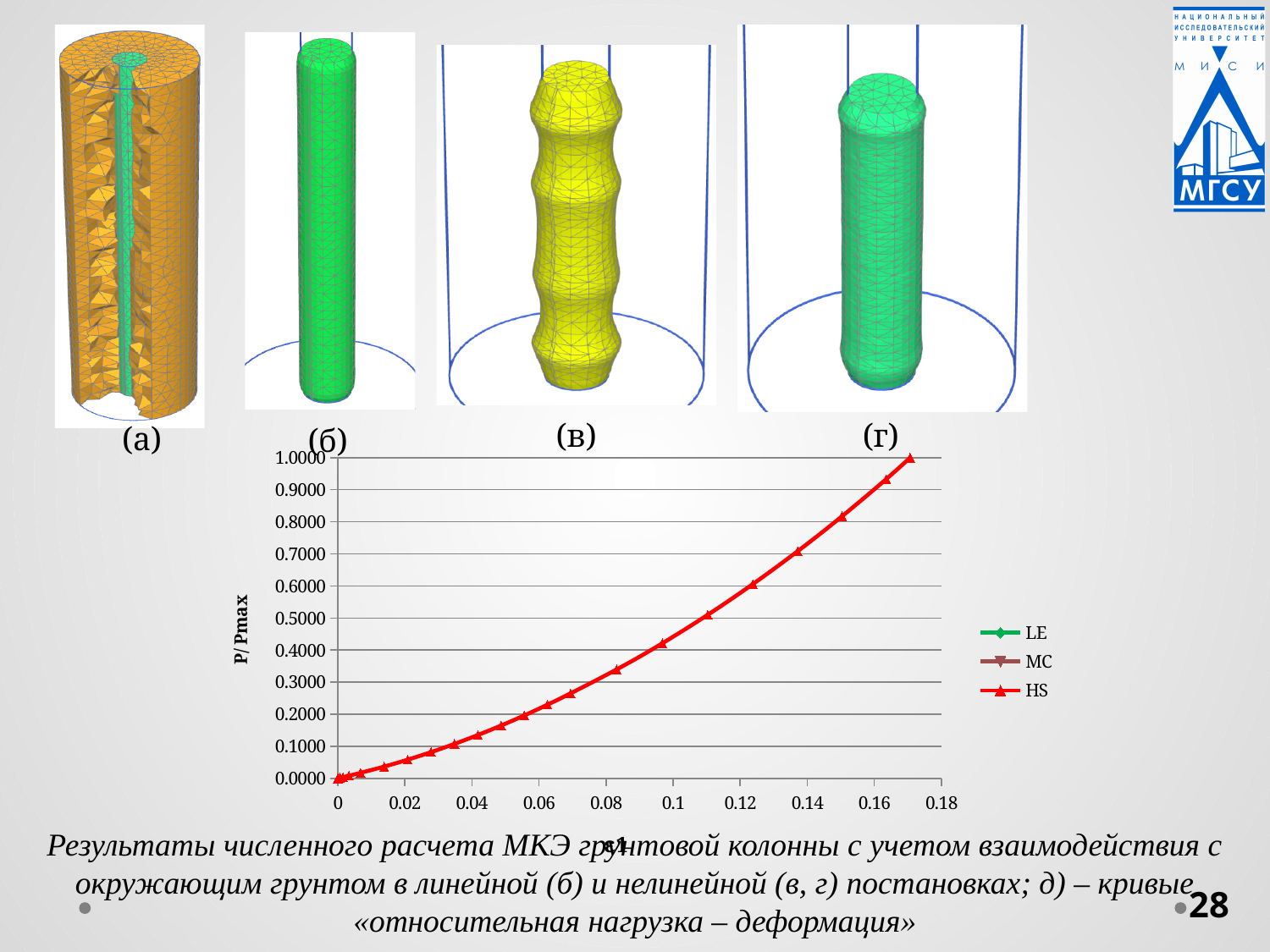
What is the label of the vertical axis of the chart? P/Pmax Is the P/Pmax value of the HS curve at x = 0.1 greater or less than 0.5000? less Is the P/Pmax value of the HS curve at x = 0.14 greater or less than 0.6000? greater What is the P/Pmax value of the HS curve at x = 0? 0.0000 What kind of chart is shown on the slide? line chart What is the highest P/Pmax value reached by the HS curve? 1.0000 What is the largest value shown on the x-axis of the chart? 0.18 Is the P/Pmax value of the HS curve at x = 0.16 greater or less than 0.8000? greater Does the HS curve rise or fall as the x-axis value increases? rises How many series does the chart legend list? 3 What are the series names listed in the chart legend? LE, MC, HS